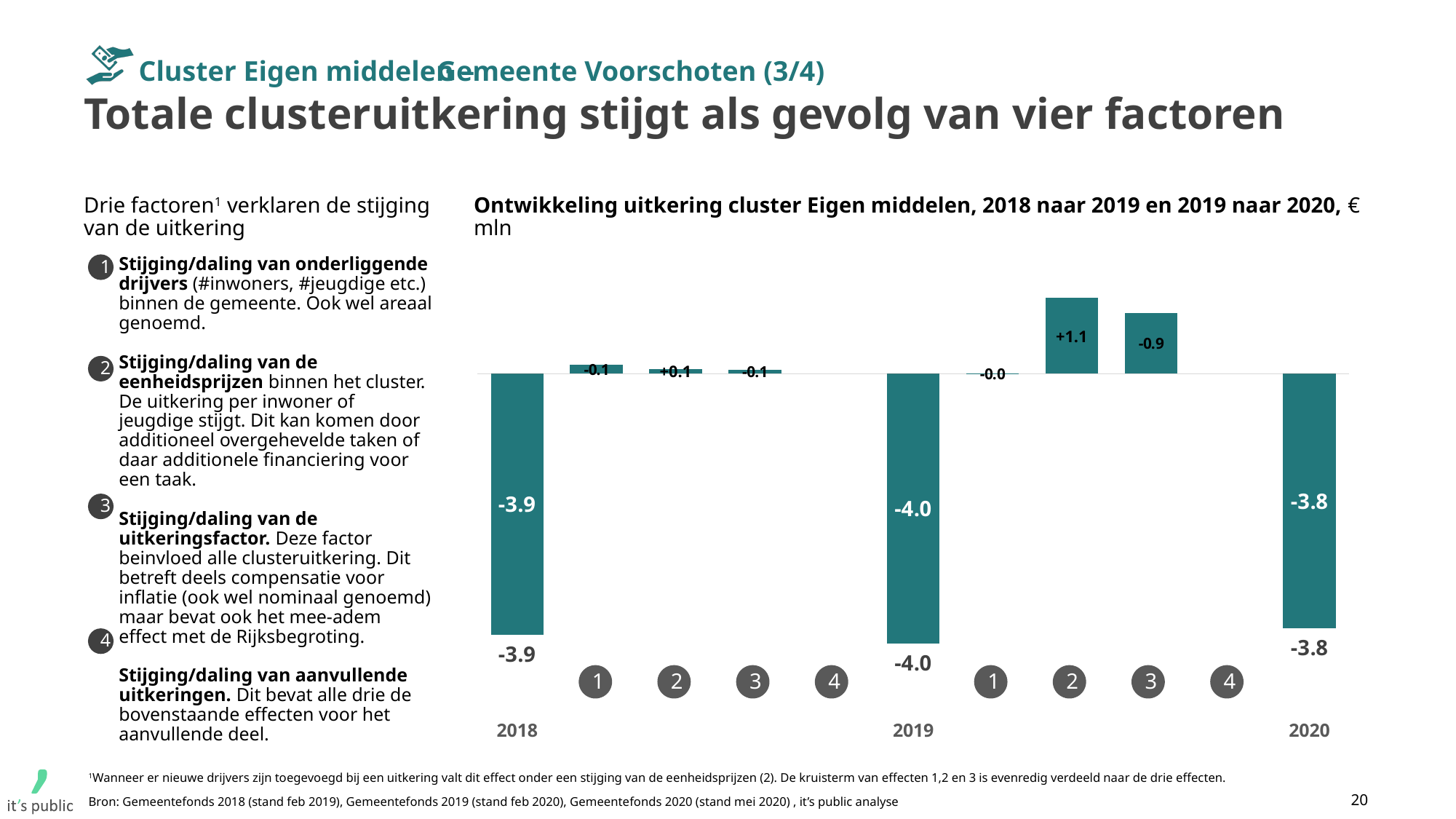
What is the total uitkering value shown for 2019? -4.0 In what unit are the values in the chart expressed, according to the chart title? € mln What is the value of factor 3 (uitkeringsfactor) in the change from 2019 to 2020? -0.9 What is the total uitkering value shown for 2018? -3.9 What is the value of factor 2 (eenheidsprijzen) in the change from 2019 to 2020? +1.1 What is the total uitkering value shown for 2020? -3.8 What is the value of factor 2 (eenheidsprijzen) in the change from 2018 to 2019? +0.1 What is the difference between the total values for 2019 (-4.0) and 2020 (-3.8)? 0.2 What kind of chart is shown on the slide? bar chart (waterfall) Which year has the highest total uitkering value: 2018, 2019 or 2020? 2020 Which year has the lowest total uitkering value: 2018, 2019 or 2020? 2019 Which is larger in absolute size: the factor 2 effect (+1.1) or the factor 3 effect (-0.9) between 2019 and 2020? factor 2 (+1.1)